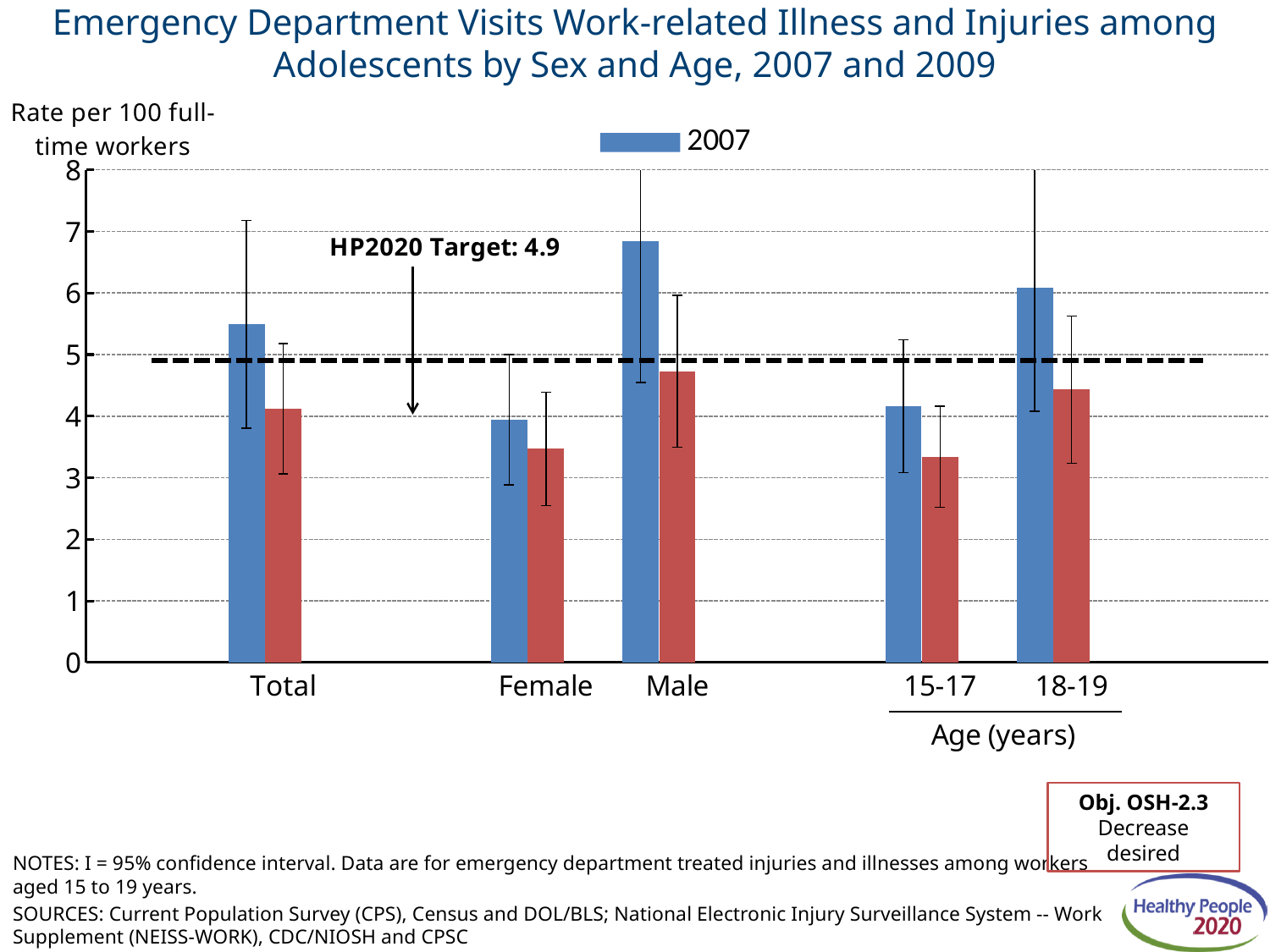
For the Total category, which bar is taller, the blue (2007) bar or the red bar? the blue (2007) bar Is the red (2009) value for 18-19 greater or less than 5? less Is the red (2009) value for 15-17 greater or less than 4? less Which is larger, the 2007 (blue) value for Male or the 2007 (blue) value for Female? Male Is the 2007 (blue) value for Total greater or less than 5? greater What is the HP2020 Target value shown by the dashed line? 4.9 Which category has the highest 2007 (blue) bar? Male What is the label of the y axis? Rate per 100 full-time workers What kind of chart is shown on the slide? bar chart How many categories are shown along the x axis? 5